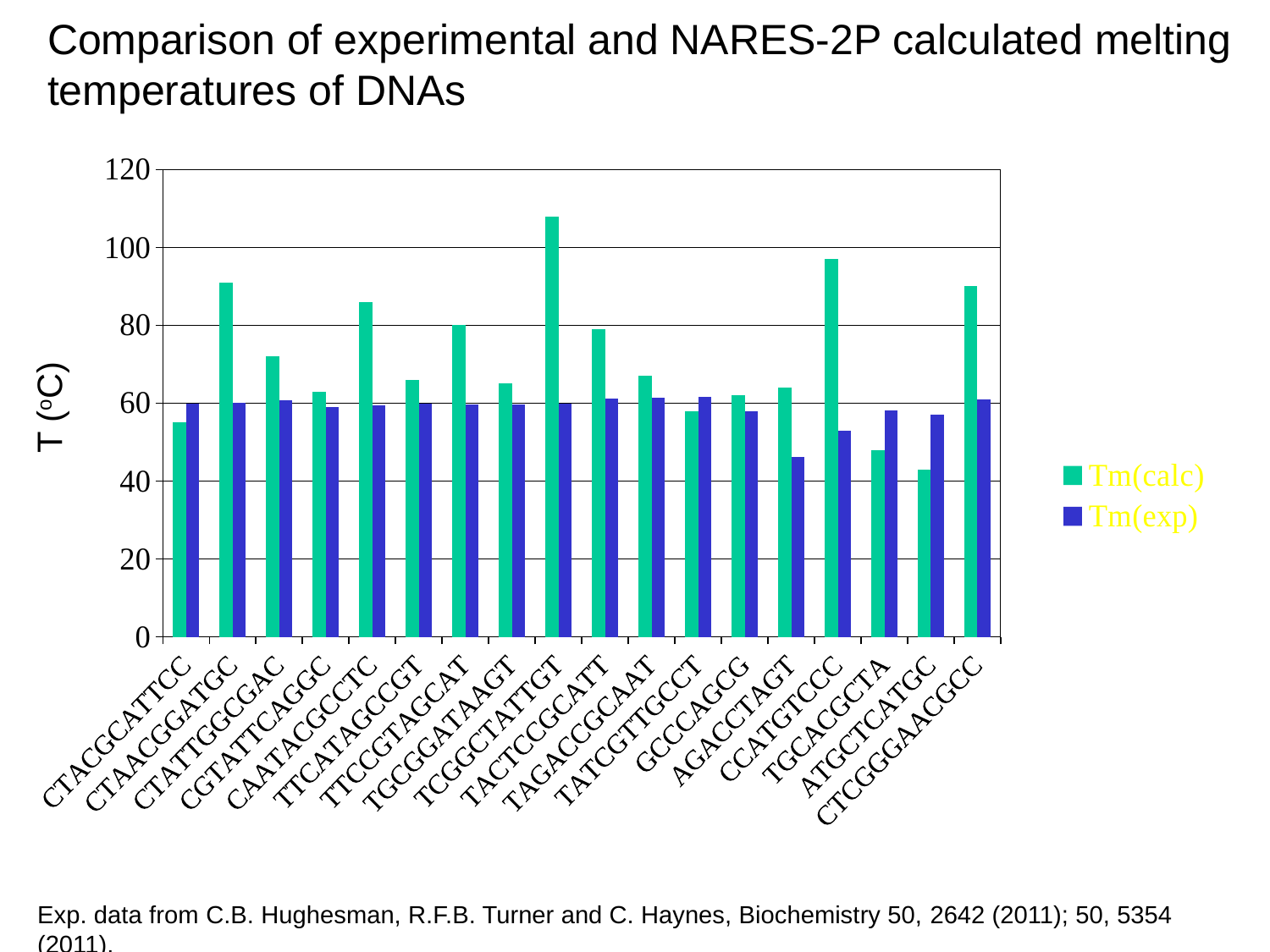
What is the label on the y axis of the chart? T (°C) How many DNA sequences (categories) are plotted along the x axis? 18 How many series does the legend list? 2 Is the Tm(calc) value for TCGGCTATTGT greater or less than 100? greater Is the Tm(calc) value for TGCACGCTA greater or less than 60? less Which DNA sequence has the lowest Tm(exp) value? AGACCTAGT What kind of chart is shown on the slide? bar chart Which DNA sequence has the lowest Tm(calc) value? ATGCTCATGC For CCATGTCCC, which is larger: Tm(calc) or Tm(exp)? Tm(calc) For ATGCTCATGC, which is larger: Tm(calc) or Tm(exp)? Tm(exp) Is the Tm(calc) value for CTAACGGATGC greater or less than 80? greater Which DNA sequence has the highest Tm(calc) value? TCGGCTATTGT